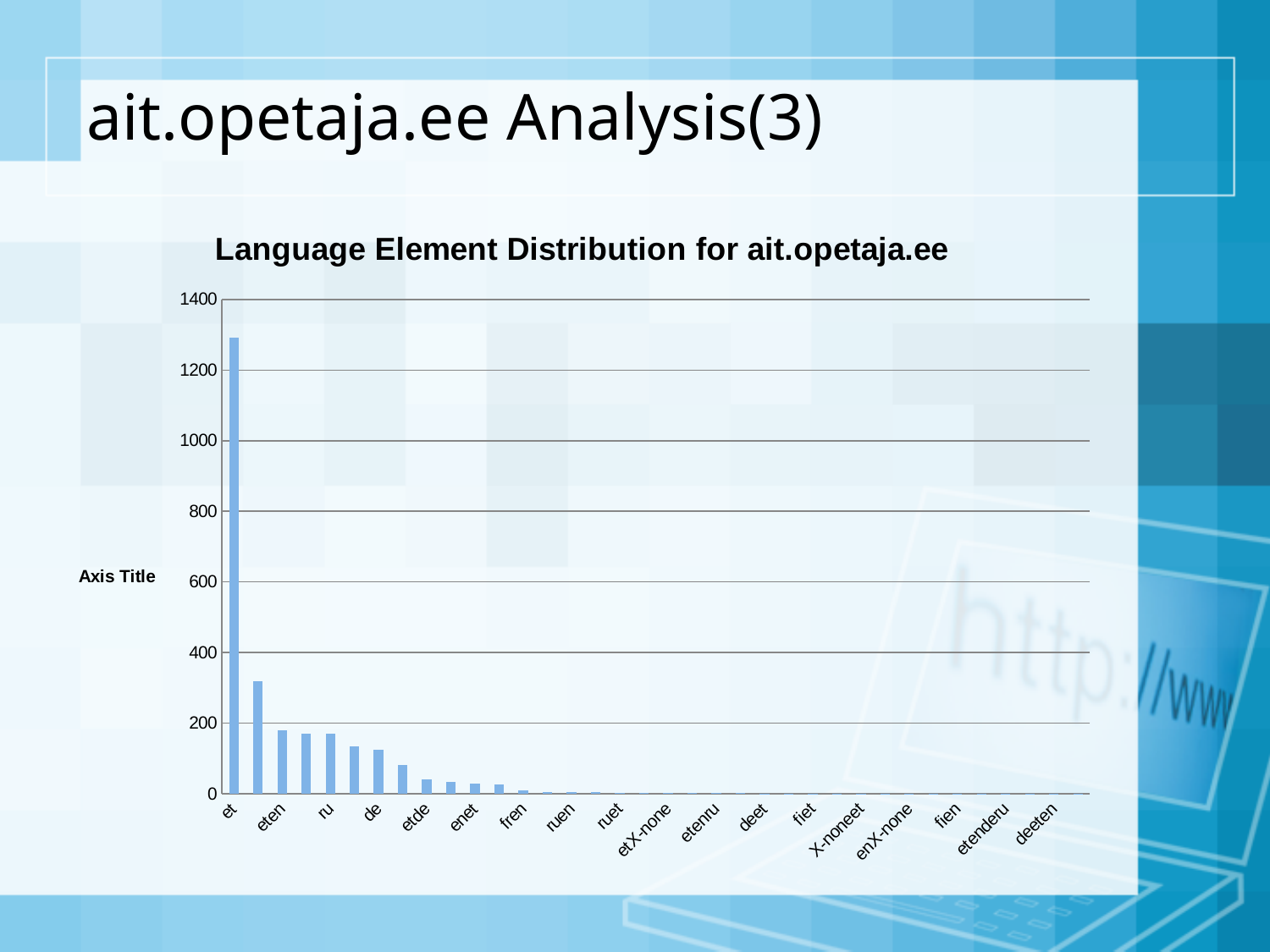
What is the title of the chart? Language Element Distribution for ait.opetaja.ee Is the value for ru greater or less than 200? less Do the values generally rise or fall moving from left to right along the x axis? fall Is the value for eten greater or less than 400? less Which is larger, the value for et or the value for eten? et Which is larger, the value for eten or the value for de? eten What kind of chart is shown on the slide? bar chart What is the label shown on the vertical axis? Axis Title Is the value for de greater or less than 200? less Which category has the highest value in the chart? et